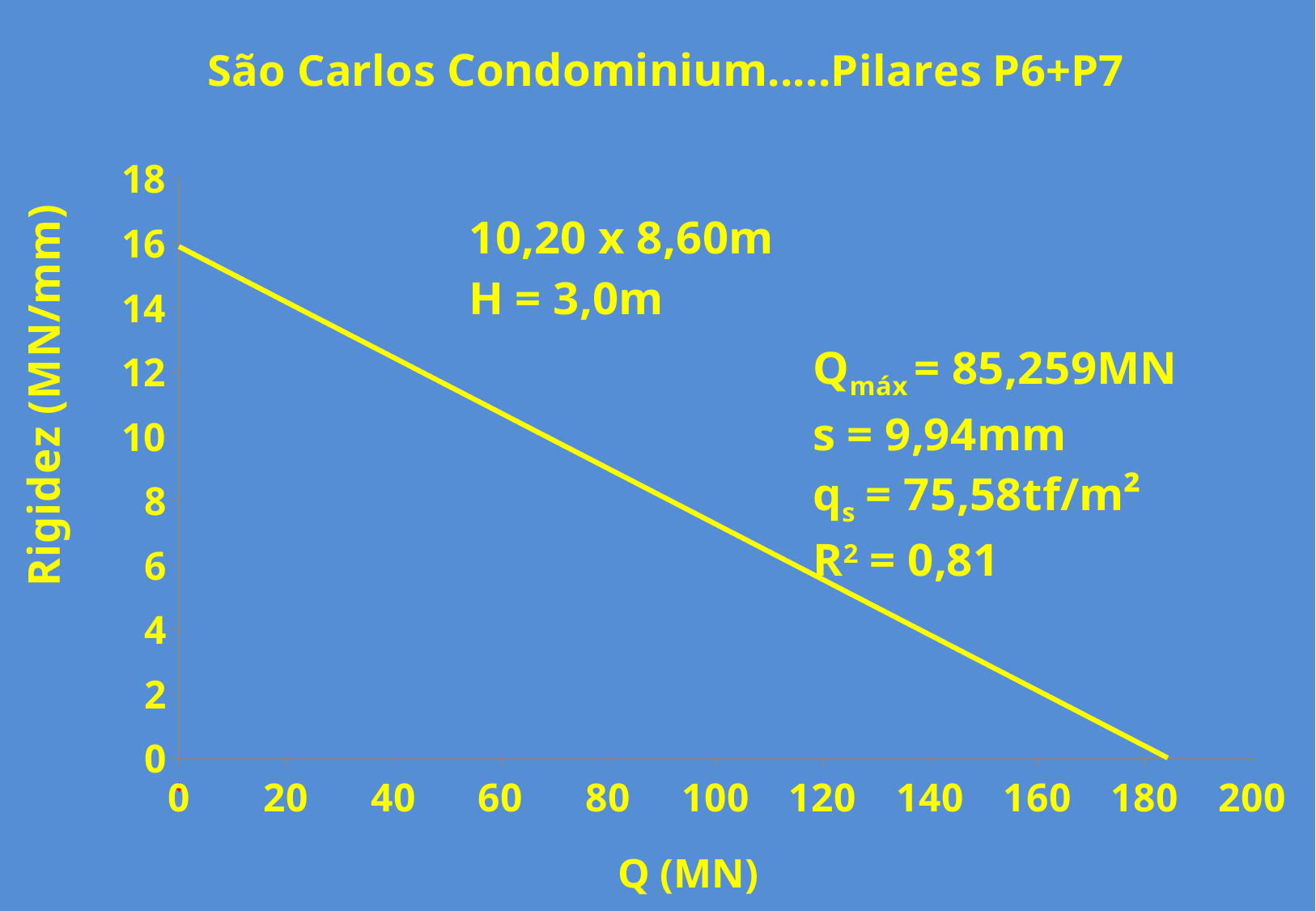
What is the Rigidez value where the line meets the y axis at Q = 0? 16 Is the Rigidez value at Q = 20 MN greater or less than 16? less Is the Rigidez value at Q = 100 MN greater or less than 6? greater What is the label of the y axis? Rigidez (MN/mm) Is the Rigidez value at Q = 160 MN greater or less than 4? less What is the title of the chart? São Carlos Condominium.....Pilares P6+P7 What kind of chart is shown on the slide? line chart Does the Rigidez value rise or fall as Q increases along the x axis? fall Which has the higher Rigidez value, Q = 40 MN or Q = 140 MN? Q = 40 MN